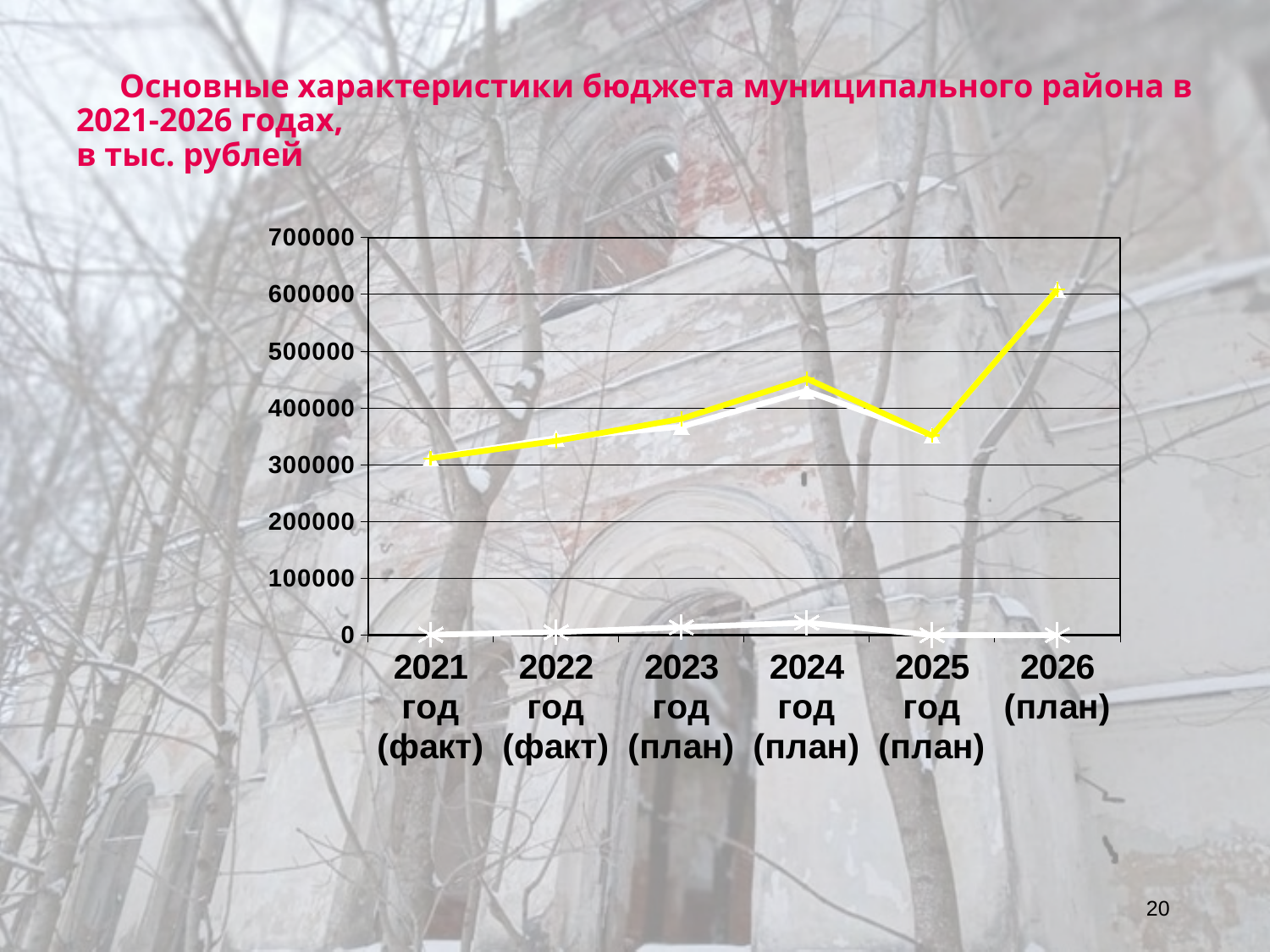
In which year does the yellow line reach its highest value? 2026 (план) How many lines are plotted on the chart? 3 Is the value of the yellow line for 2025 год (план) greater or less than 400000? less Is the value of the yellow line for 2026 (план) greater or less than 500000? greater In which year does the yellow line have its lowest value? 2021 год (факт) How many year categories are shown along the x axis of the chart? 6 Does the yellow line rise or fall between 2025 год (план) and 2026 (план)? rise Which is larger for the yellow line: the value for 2024 год (план) or the value for 2025 год (план)? 2024 год (план) What kind of chart is shown on the slide? line chart Is the value of the lowest white line for 2024 год (план) greater or less than 100000? less In what units are the budget values on the slide expressed, according to the title? тыс. рублей